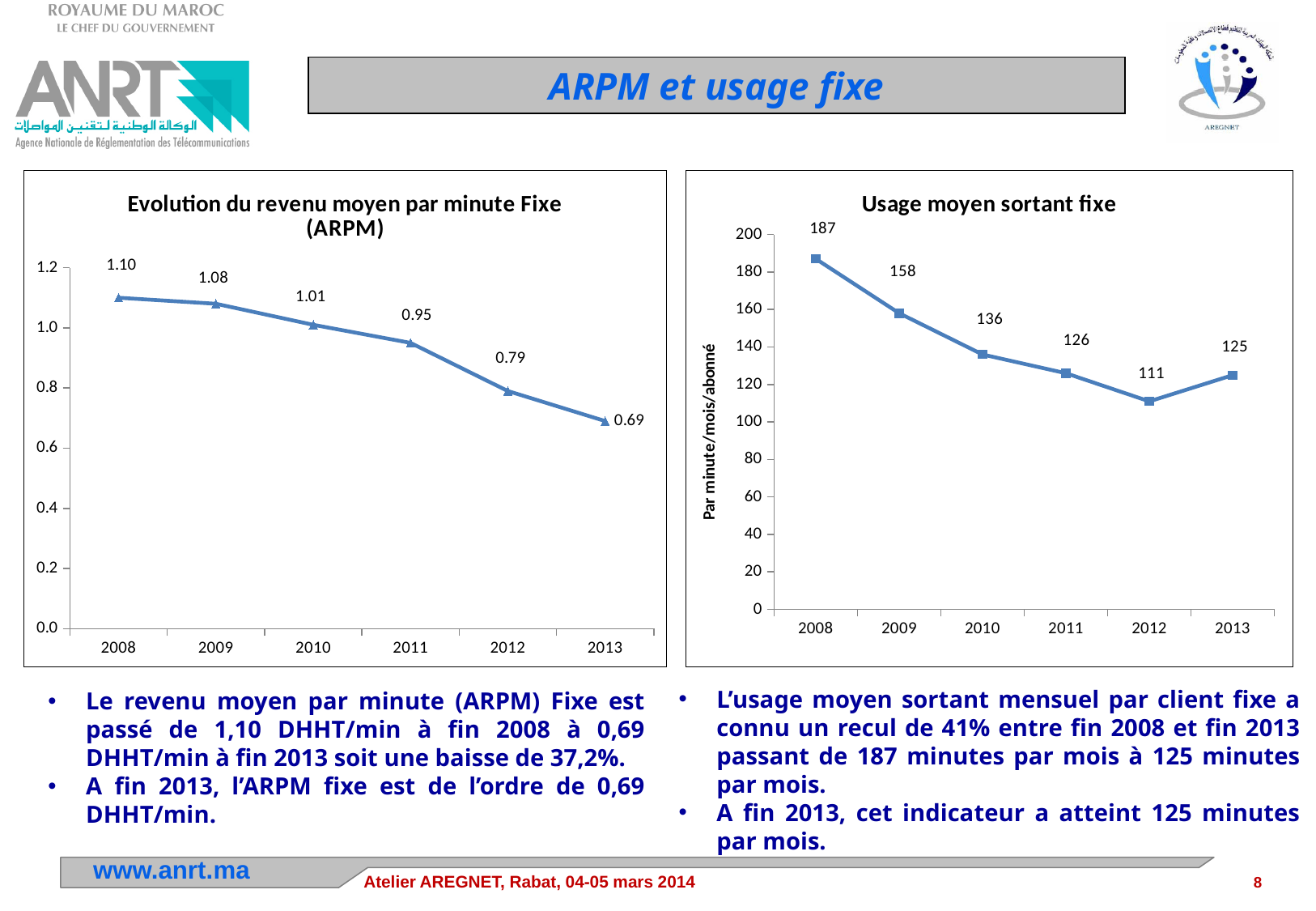
In the 'Usage moyen sortant fixe' chart, what is the value for 2011? 126 In the 'Evolution du revenu moyen par minute Fixe (ARPM)' chart, how many years are plotted? 6 What is the y-axis label of the 'Usage moyen sortant fixe' chart? Par minute/mois/abonné In the 'Evolution du revenu moyen par minute Fixe (ARPM)' chart, do the values rise or fall from 2008 to 2013? fall What kind of chart is the 'Usage moyen sortant fixe' chart? line chart In the 'Evolution du revenu moyen par minute Fixe (ARPM)' chart, what is the difference between the 2008 and 2013 values? 0.41 In the 'Usage moyen sortant fixe' chart, which year has the lowest value? 2012 In the 'Evolution du revenu moyen par minute Fixe (ARPM)' chart, which year has the lowest value? 2013 In the 'Usage moyen sortant fixe' chart, which is larger, the value for 2010 or the value for 2013? 2010 In the 'Usage moyen sortant fixe' chart, what is the difference between the 2008 and 2009 values? 29 In the 'Usage moyen sortant fixe' chart, which year has the highest value? 2008 In the 'Evolution du revenu moyen par minute Fixe (ARPM)' chart, what is the value for 2010? 1.01